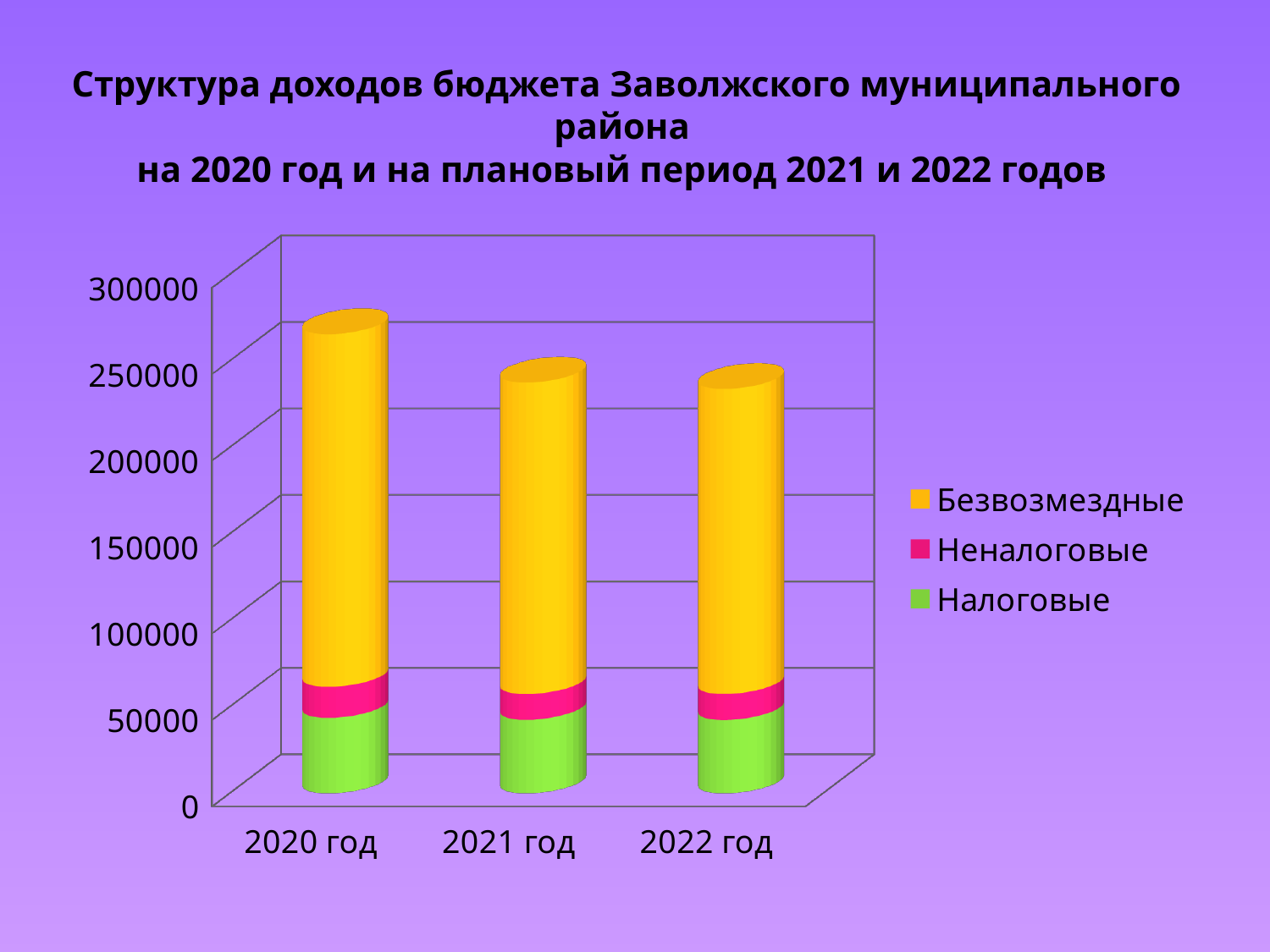
Which total is larger, 2020 год or 2021 год? 2020 год Which series is shown in green in the legend? Налоговые Is the total for 2020 год greater or less than 250000? greater How many series does the legend list? 3 Which year has the highest total bar? 2020 год How many years (categories) are shown on the x axis? 3 What kind of chart is shown on the slide? Stacked bar chart Is the total for 2022 год greater or less than 200000? greater Is the Налоговые value for 2021 год greater or less than 100000? less Do the total bar heights rise or fall from 2020 год to 2022 год? fall Which series makes up the largest part of each bar? Безвозмездные What colour represents the Безвозмездные series? Yellow